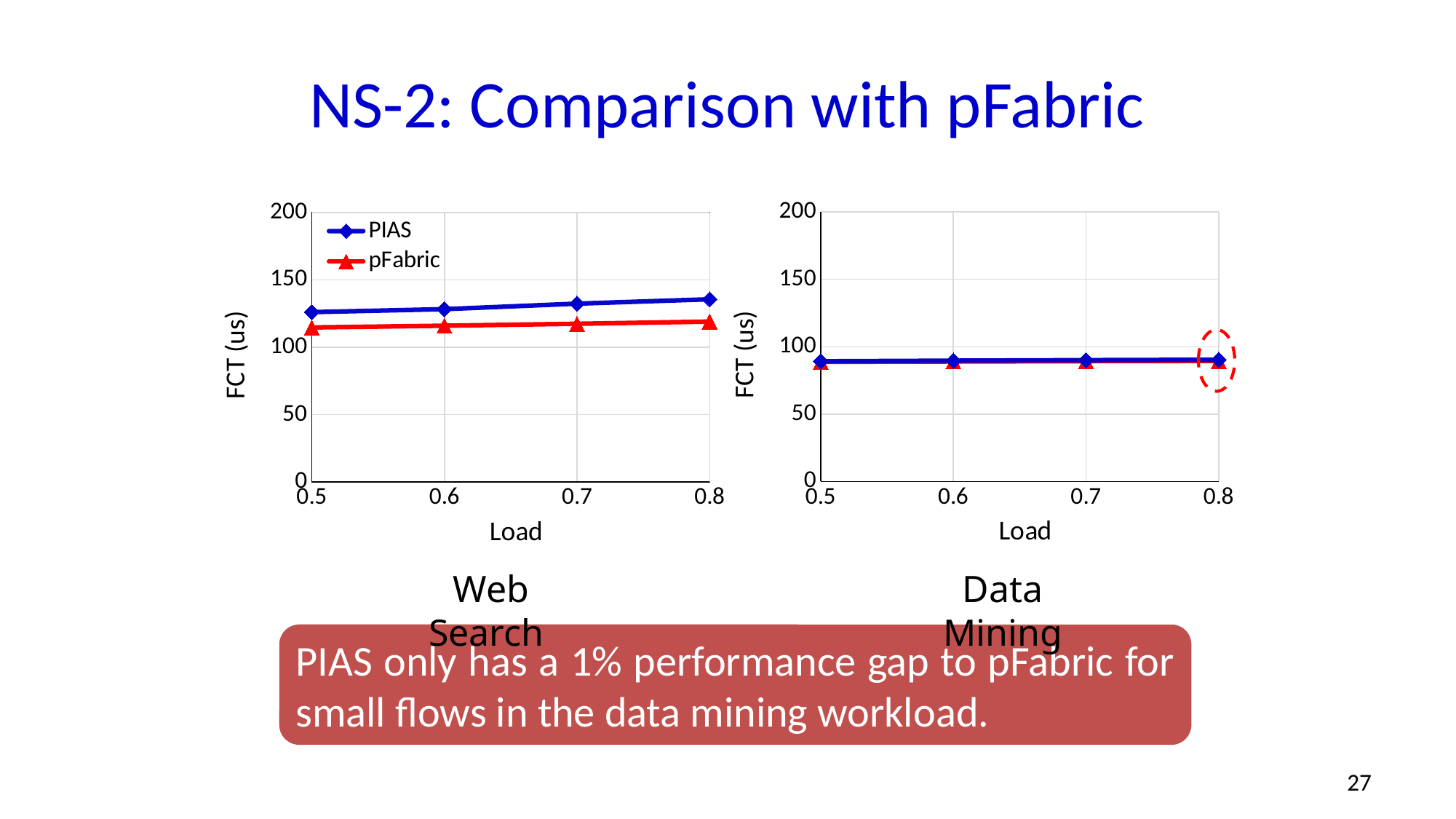
In the Data Mining chart, is the PIAS value at load 0.8 greater or less than 100? less In the Web Search chart, which series has the lower FCT at load 0.5, PIAS or pFabric? pFabric How many series does the legend of the Web Search chart list? 2 In the Web Search chart, is the PIAS value at load 0.8 greater or less than 150? less In the Web Search chart, which series has the higher FCT at load 0.8, PIAS or pFabric? PIAS In the Web Search chart, is the pFabric value at load 0.5 greater or less than 100? greater How many load values are plotted along the x axis of the Data Mining chart? 4 What kind of chart is the Web Search chart on the left? line chart Which series in the Web Search chart is drawn in red with triangle markers? pFabric In the Web Search chart, does the PIAS line rise or fall as load increases from 0.5 to 0.8? rise What is the y-axis label on the Data Mining chart? FCT (us)